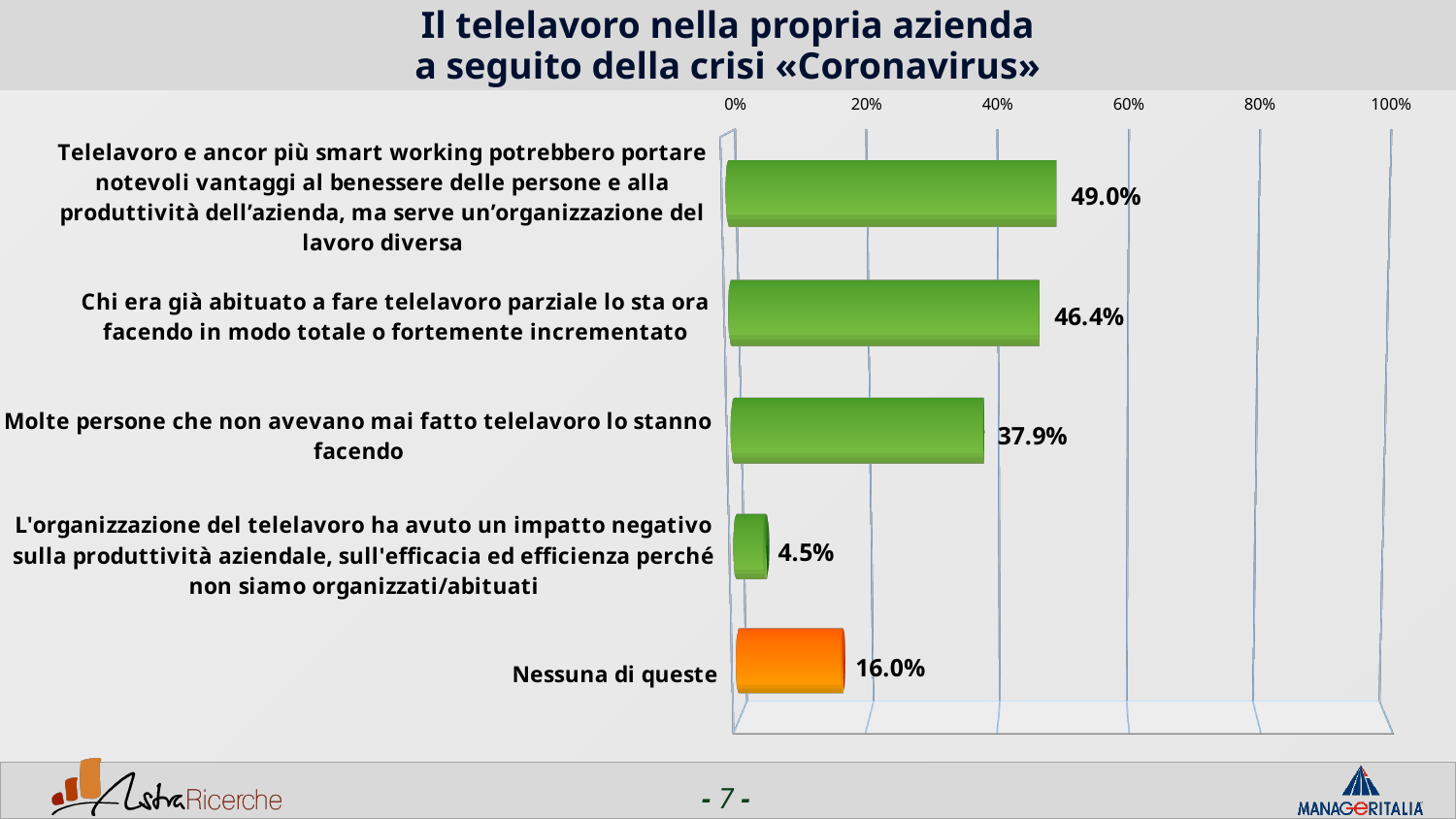
Which bar is coloured orange rather than green? Nessuna di queste Which category has the lowest value? L'organizzazione del telelavoro ha avuto un impatto negativo sulla produttività aziendale, sull'efficacia ed efficienza perché non siamo organizzati/abituati What is the value for "Nessuna di queste"? 16.0% Which category has the highest value? Telelavoro e ancor più smart working potrebbero portare notevoli vantaggi al benessere delle persone e alla produttività dell'azienda, ma serve un'organizzazione del lavoro diversa Is the value for "Chi era già abituato a fare telelavoro parziale..." greater or less than 40%? greater What kind of chart is shown on the slide? Bar chart What is the difference between the highest value (49.0%) and the value for "Molte persone che non avevano mai fatto telelavoro lo stanno facendo"? 11.1% How many categories are shown in the chart? 5 What is the difference between the value for "Nessuna di queste" and the value for "L'organizzazione del telelavoro ha avuto un impatto negativo..."? 11.5% Which is larger: the value for "Nessuna di queste" or the value for "Molte persone che non avevano mai fatto telelavoro lo stanno facendo"? Molte persone che non avevano mai fatto telelavoro lo stanno facendo What is the value for "Molte persone che non avevano mai fatto telelavoro lo stanno facendo"? 37.9% What is the value for "Chi era già abituato a fare telelavoro parziale lo sta ora facendo in modo totale o fortemente incrementato"? 46.4%